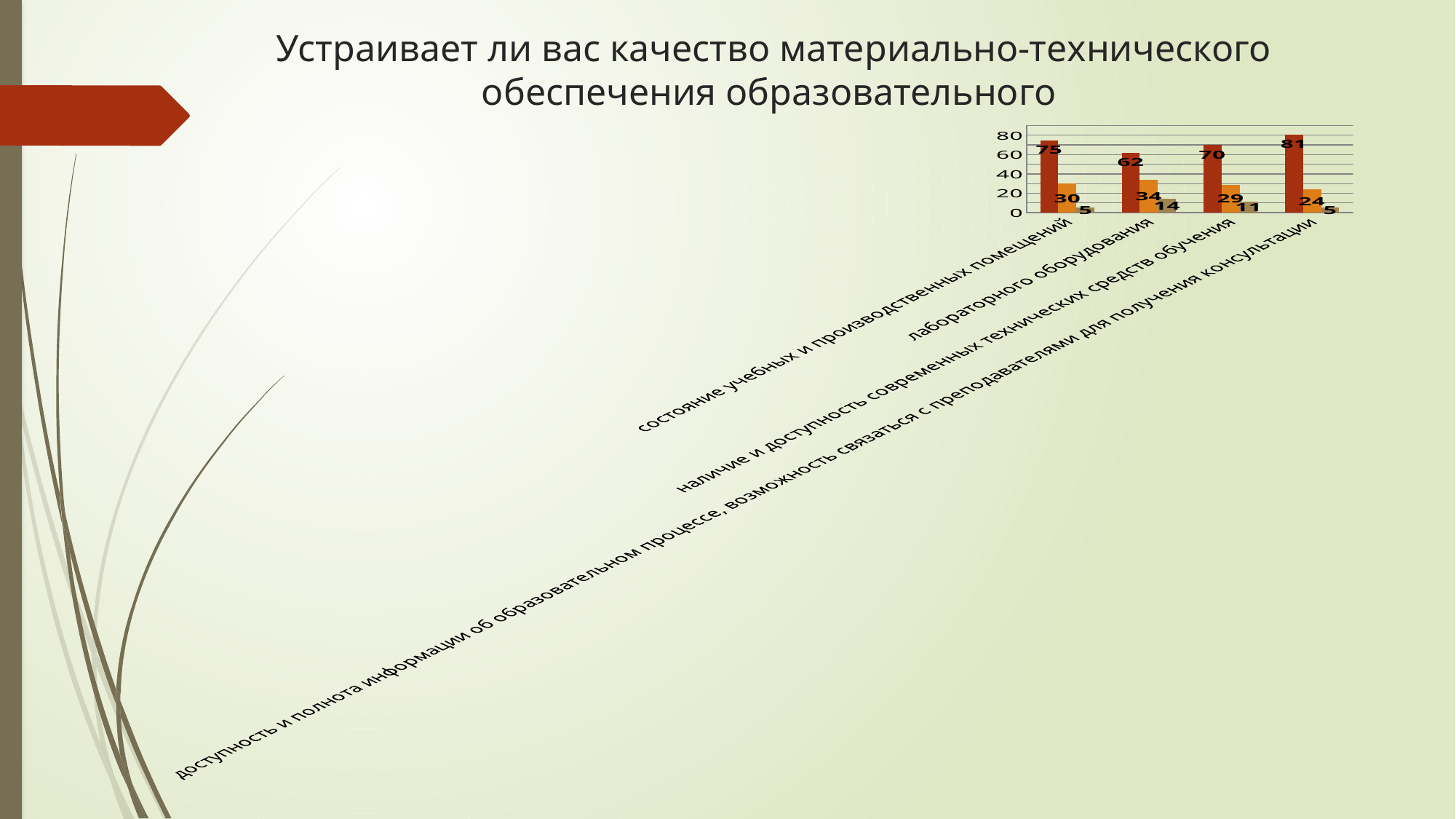
What kind of chart is shown on the slide? bar chart What is the value of the orange bar for "лабораторного оборудования"? 34 Which category has the highest brown bar? лабораторного оборудования Which category has the lowest red bar? лабораторного оборудования Which category has the highest red bar? доступность и полнота информации об образовательном процессе, возможность связаться с преподавателями для получения консультации What is the difference between the red bar values for "доступность и полнота информации об образовательном процессе..." (81) and "лабораторного оборудования" (62)? 19 How many bars are shown for each category in the chart? 3 How many categories are shown on the x axis of the chart? 4 What is the value of the red bar for "состояние учебных и производственных помещений"? 75 Which is larger: the orange bar for "состояние учебных и производственных помещений" or the orange bar for "лабораторного оборудования"? лабораторного оборудования What is the value of the brown bar for "наличие и доступность современных технических средств обучения"? 11 What is the value of the red bar for "доступность и полнота информации об образовательном процессе, возможность связаться с преподавателями для получения консультации"? 81